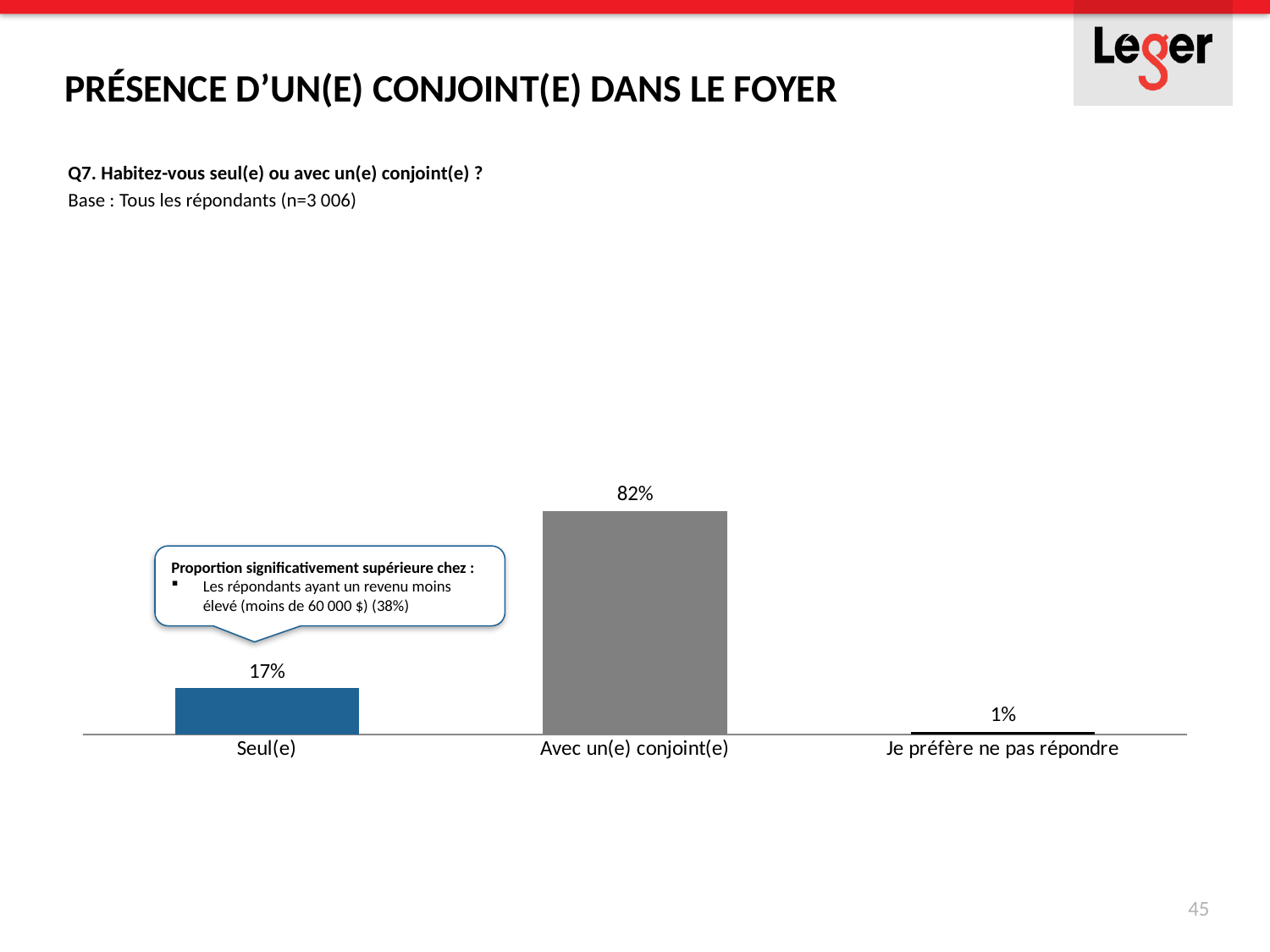
What kind of chart is shown on the slide? Bar chart According to the callout box, what is the proportion of Seul(e) among respondents with income below 60 000 $? 38% What is the sample size (n) stated in the base line above the chart? 3 006 How many categories are shown in the chart? 3 Which category has the lowest value? Je préfère ne pas répondre What is the value for Seul(e)? 17% What is the value for Avec un(e) conjoint(e)? 82% Which category has the highest value? Avec un(e) conjoint(e) What is the difference between the values for Seul(e) and Je préfère ne pas répondre? 16% What is the difference between the values for Avec un(e) conjoint(e) and Seul(e)? 65% What is the value for Je préfère ne pas répondre? 1% Which is larger, the value for Seul(e) or the value for Avec un(e) conjoint(e)? Avec un(e) conjoint(e)